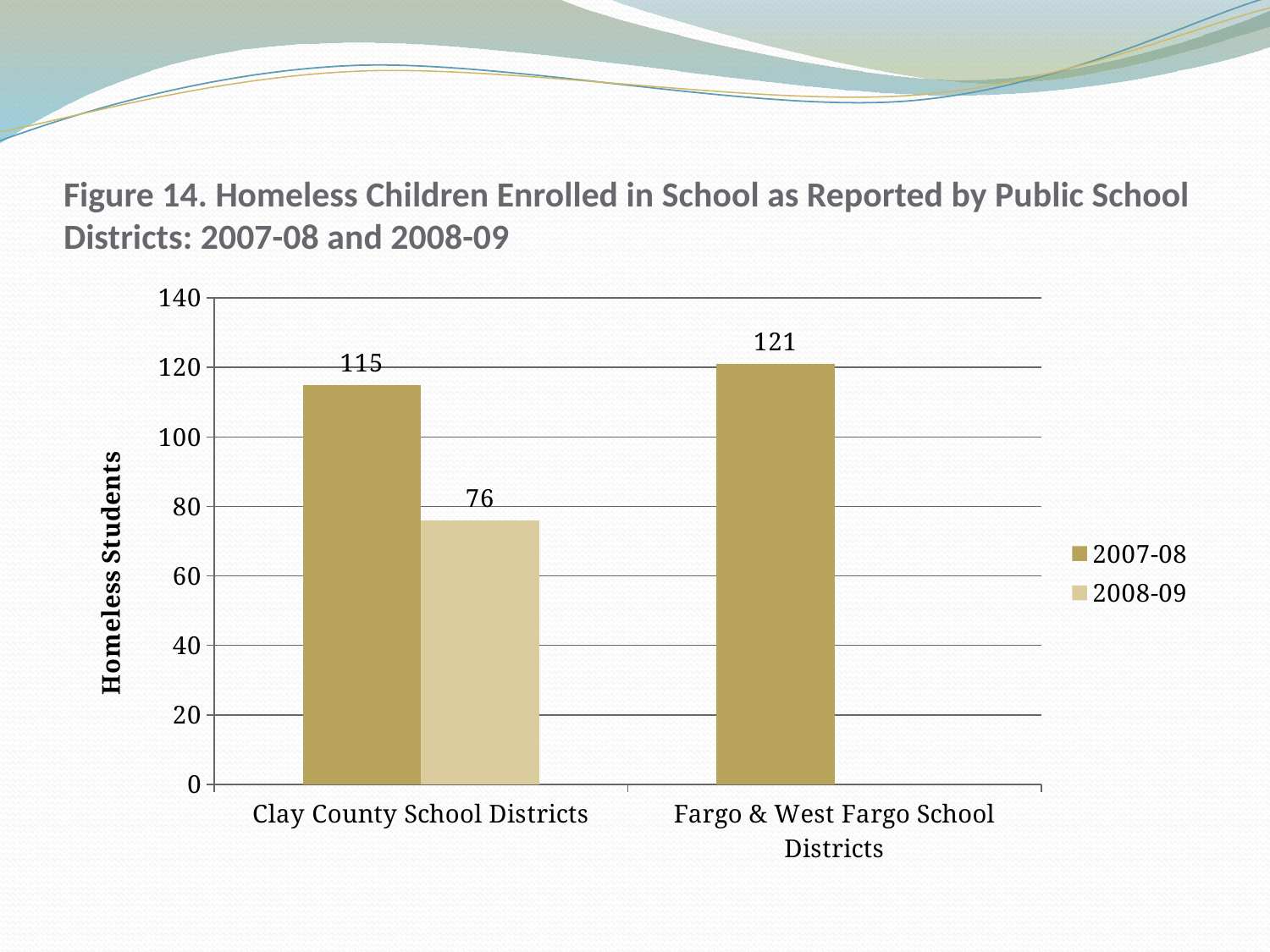
Which category has the highest 2007-08 value? Fargo & West Fargo School Districts Is the 2007-08 value for Fargo & West Fargo School Districts greater or less than 100? greater What is the value for Clay County School Districts in 2008-09? 76 What is the value for Clay County School Districts in 2007-08? 115 How many categories are shown on the x axis? 2 Which is larger: the 2007-08 value for Clay County School Districts or the 2008-09 value for Clay County School Districts? 2007-08 What is the difference between the 2007-08 and 2008-09 values for Clay County School Districts? 39 What is the difference between the 2007-08 values for Fargo & West Fargo School Districts and Clay County School Districts? 6 What is the value for Fargo & West Fargo School Districts in 2007-08? 121 What kind of chart is shown on the slide? bar chart How many series does the legend list? 2 What is the label of the y axis? Homeless Students